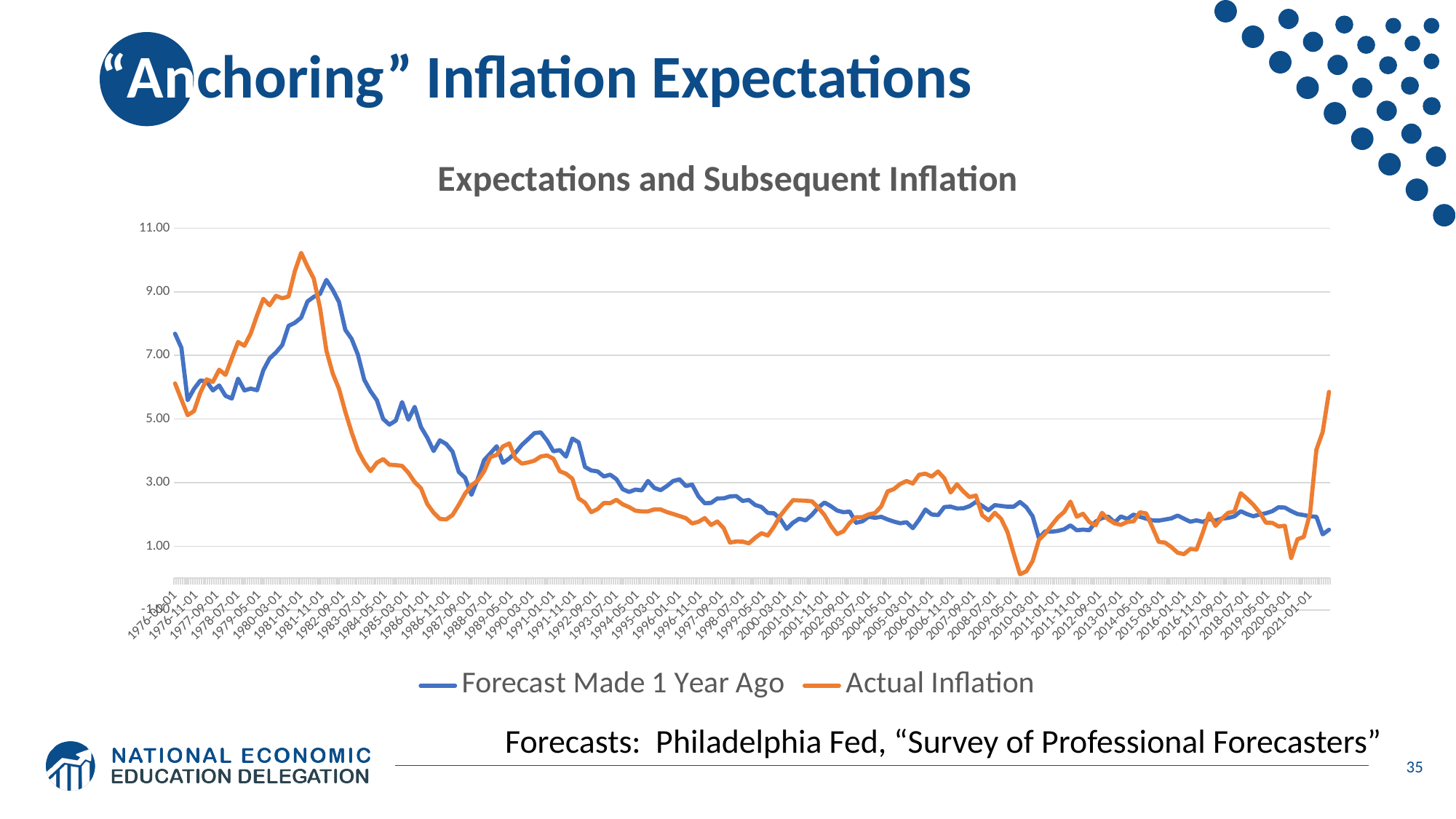
Which series is drawn in orange? Actual Inflation Is the value of Forecast Made 1 Year Ago at the start of the series in 1976 greater or less than 5.00? greater What kind of chart is shown on the slide? Line chart Is the final value of Actual Inflation at the right end of the chart (2021) greater or less than 5.00? greater Which series reaches the higher peak value in the early 1980s, Forecast Made 1 Year Ago or Actual Inflation? Actual Inflation How many series does the legend list? 2 Do the values of Actual Inflation generally rise or fall between 1981 and 1986? fall What is the title of the chart? Expectations and Subsequent Inflation Is the lowest value of Actual Inflation, around 2009, greater or less than 1.00? less Around 2009, which series has the lower value, Forecast Made 1 Year Ago or Actual Inflation? Actual Inflation